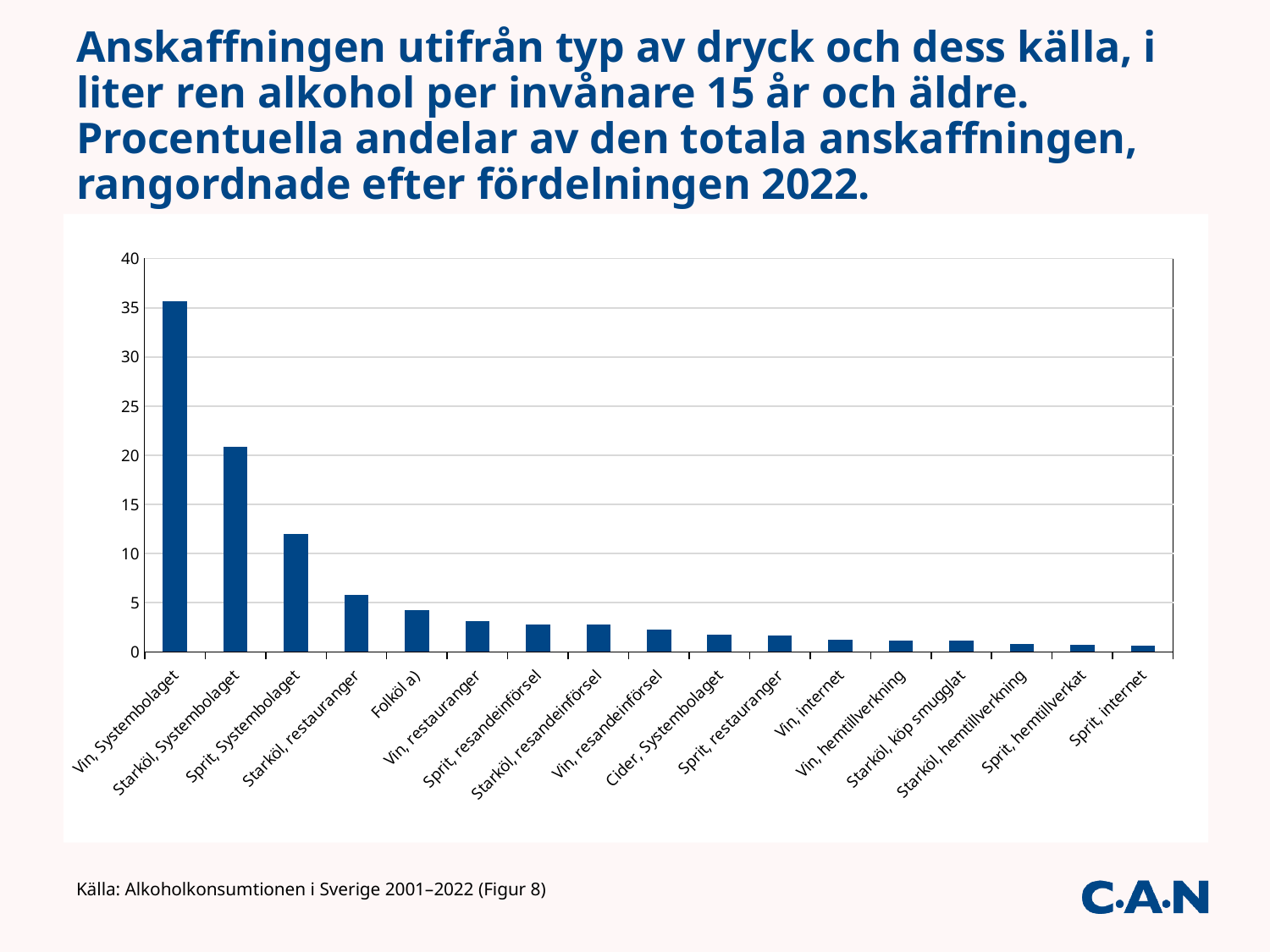
Is the value for Sprit, Systembolaget greater or less than 10? greater Is the value for Vin, restauranger greater or less than 5? less Which is larger, the value for Starköl, restauranger or the value for Folköl a)? Starköl, restauranger Which is larger, the value for Starköl, Systembolaget or the value for Sprit, Systembolaget? Starköl, Systembolaget Is the value for Starköl, Systembolaget greater or less than 20? greater Do the values rise or fall moving from left to right along the x axis? Fall How many categories are shown on the x axis of the chart? 17 Which category has the highest value in the chart? Vin, Systembolaget What source is cited below the chart? Alkoholkonsumtionen i Sverige 2001–2022 (Figur 8) What kind of chart is shown on the slide? Bar chart